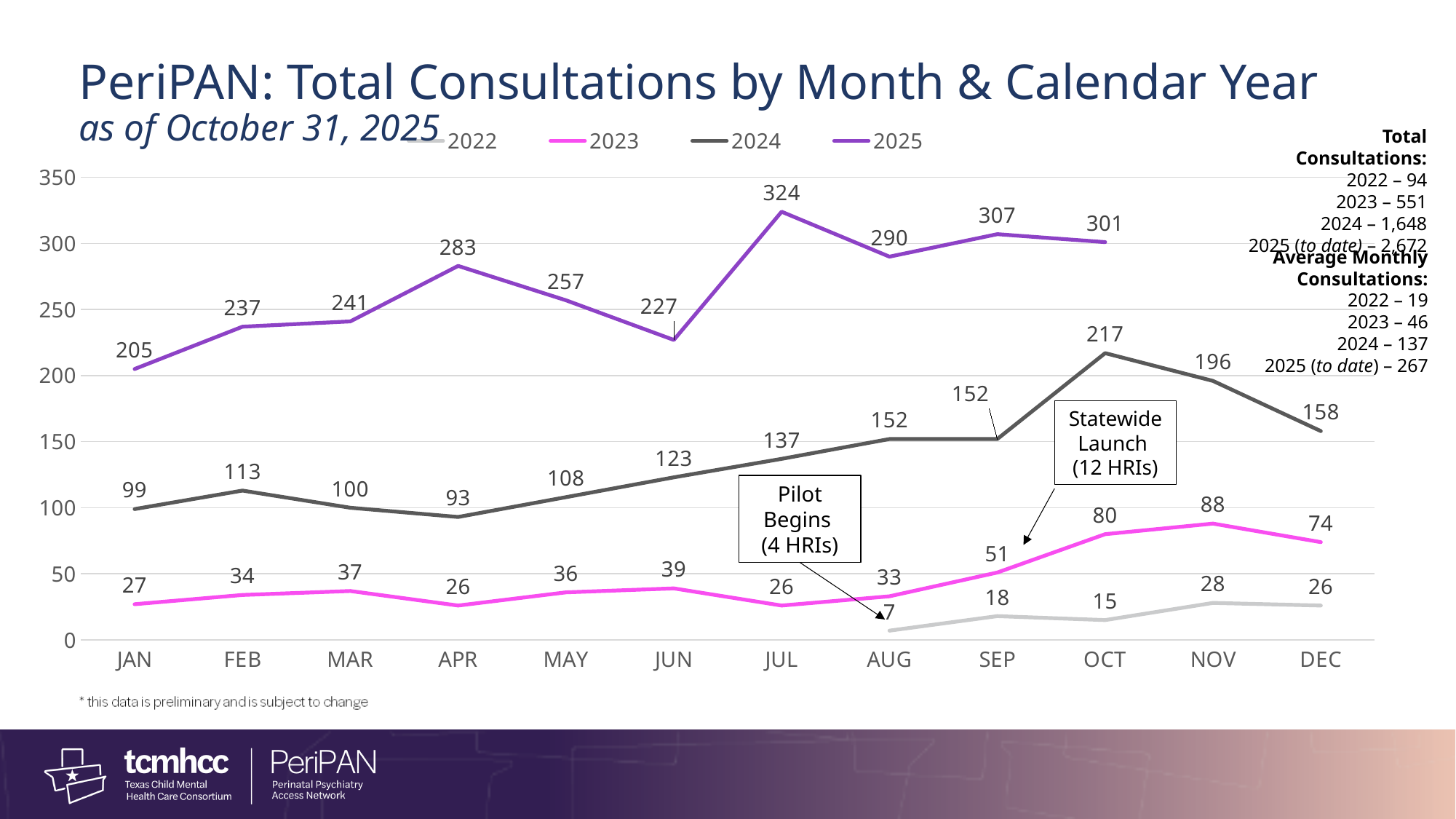
What type of chart is shown on the slide? Line chart How many months are shown on the x axis? 12 How many series does the legend list? 4 What is the value for 2023 in November? 88 In which month does the 2025 series reach its highest value? JUL What is the value for 2025 in July? 324 Which is larger, the 2024 value in November or the 2024 value in December? November In which month does the 2024 series have its lowest value? APR What is the value for 2022 in August? 7 What is the difference between the 2025 and 2024 values in January? 106 Does the 2024 series rise or fall from April to October? Rise What is the value for 2024 in October? 217